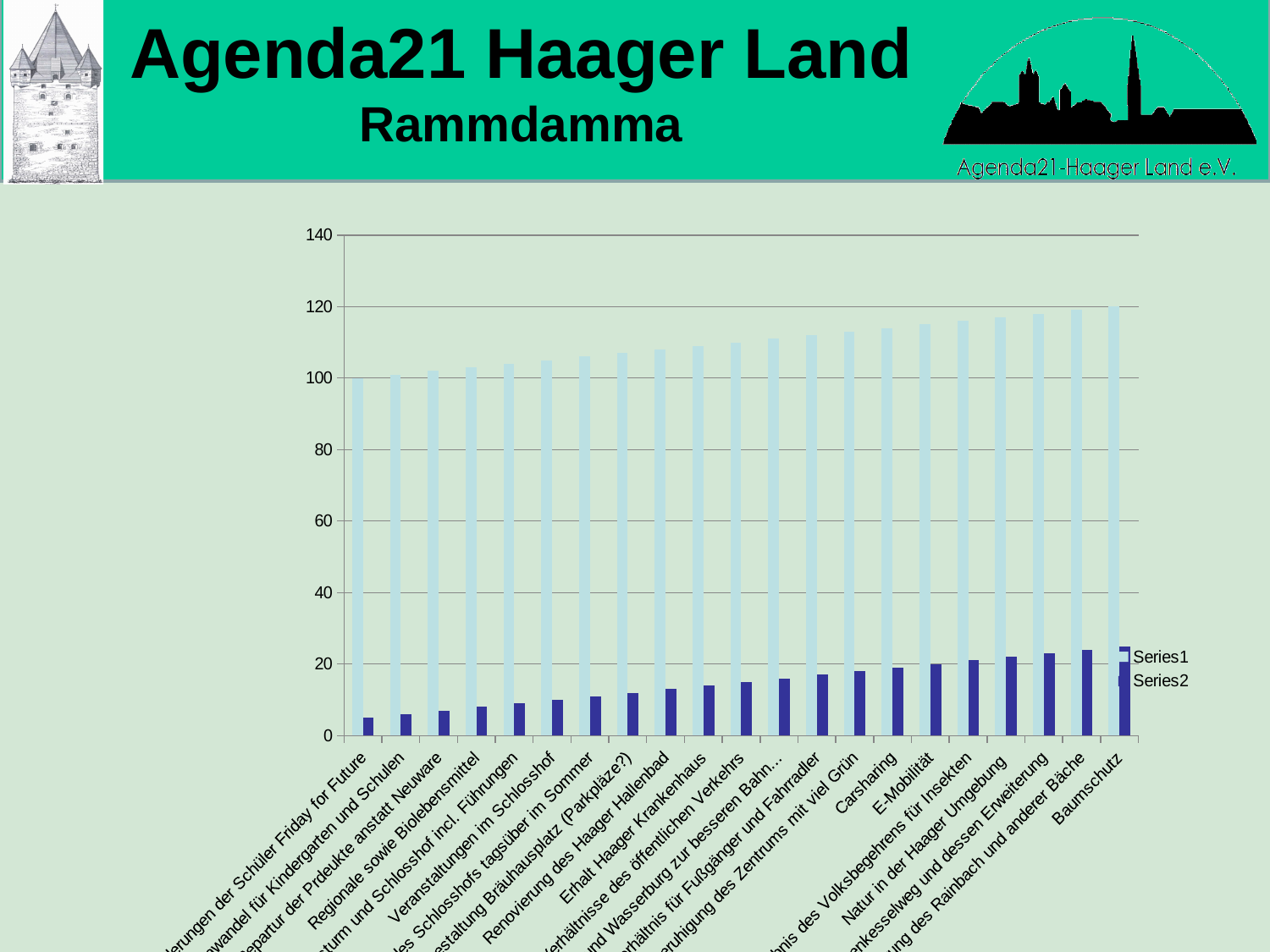
How many series does the legend list? 2 Which category has the highest Series1 value? Baumschutz How many categories are plotted along the x axis? 21 For E-Mobilität, which series has the larger value, Series1 or Series2? Series1 Which has the larger Series2 value, Baumschutz or Carsharing? Baumschutz What kind of chart is shown on the slide? bar chart Is the Series1 value for Carsharing greater or less than 100? greater Do the Series2 values rise or fall from left to right along the x axis? rise Is the Series2 value for Baumschutz greater or less than 20? greater Is the Series2 value for Regionale sowie Biolebensmittel greater or less than 20? less Which category has the highest Series2 value? Baumschutz Do the Series1 values rise or fall from left to right along the x axis? rise